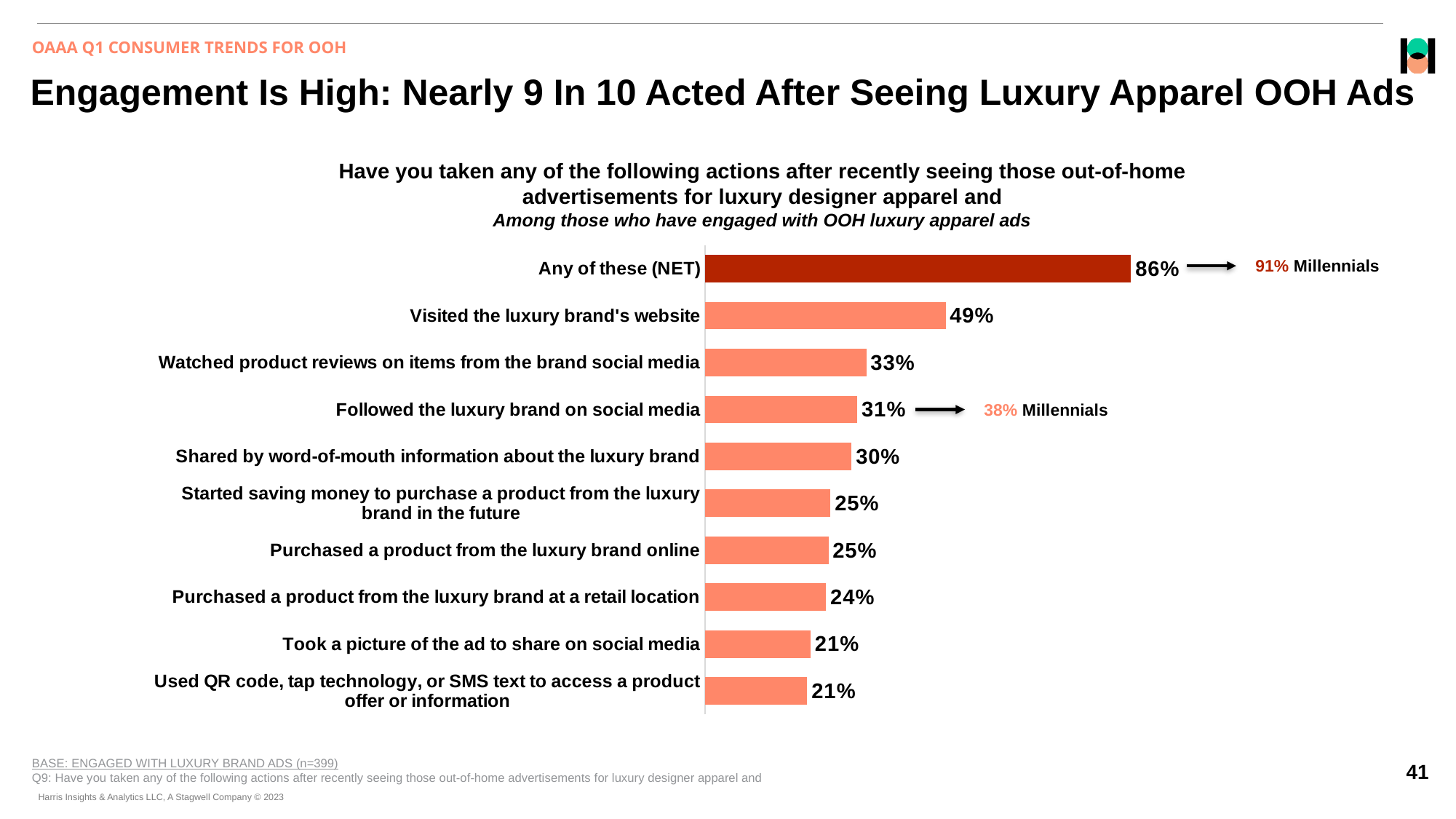
What percentage followed the luxury brand on social media? 31% What is the difference between the NET value and 'Visited the luxury brand's website'? 37% What is the value for 'Any of these (NET)'? 86% What type of chart is shown on the slide? Bar chart Which is larger: 'Shared by word-of-mouth information about the luxury brand' or 'Purchased a product from the luxury brand online'? Shared by word-of-mouth information about the luxury brand Excluding the NET bar, which action has the highest percentage? Visited the luxury brand's website What is the difference between 'Visited the luxury brand's website' and 'Watched product reviews on items from the brand social media'? 16% What percentage of respondents visited the luxury brand's website after seeing the OOH ads? 49% What is the Millennials value shown next to 'Any of these (NET)'? 91% What is the Millennials value shown next to 'Followed the luxury brand on social media'? 38% What percentage purchased a product from the luxury brand at a retail location? 24% How many bars are shown in the chart, including the NET bar? 10